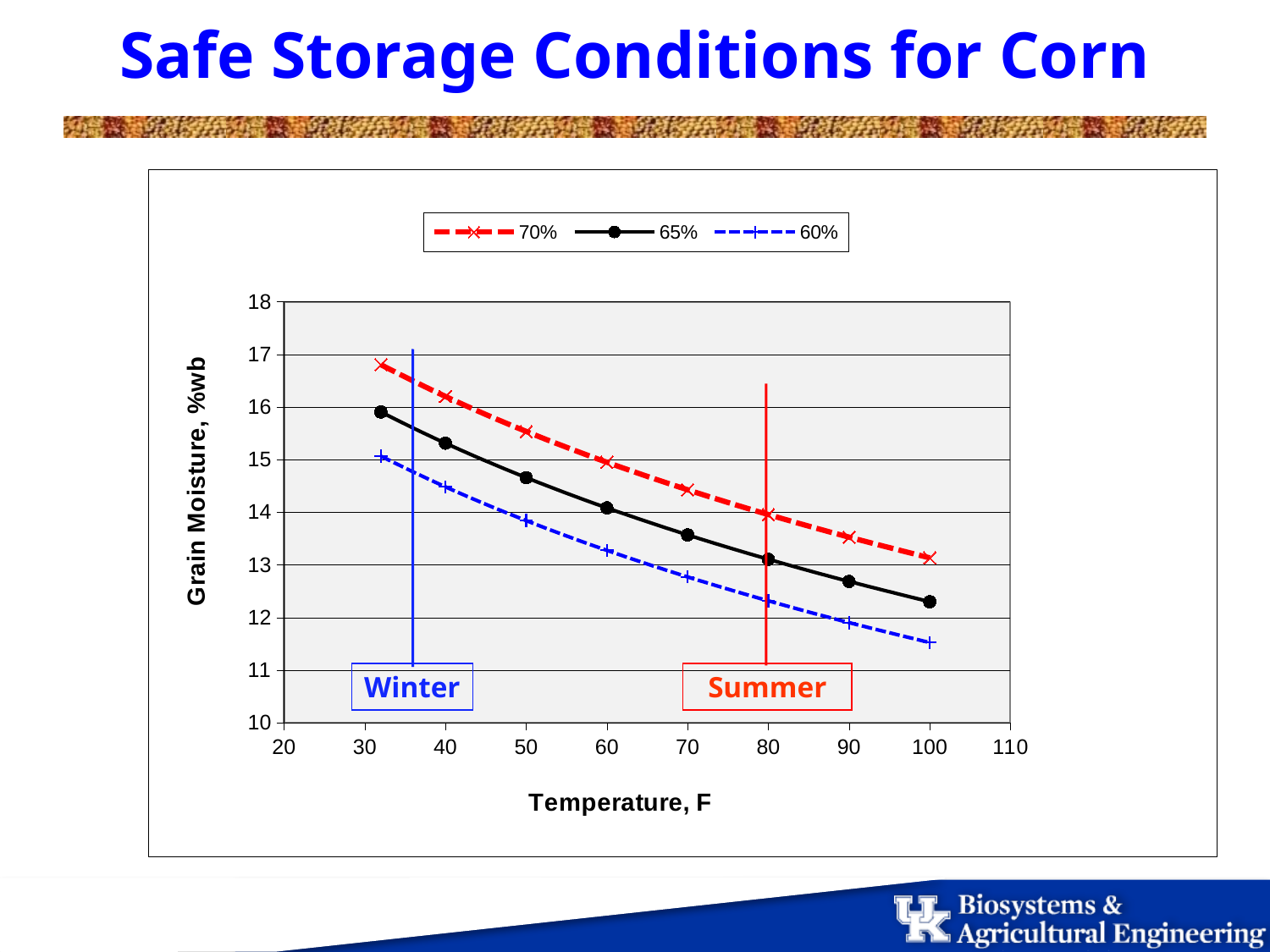
At 60 F, which series has the larger grain moisture value, 70% or 60%? 70% As temperature increases along the x axis, do the grain moisture values rise or fall? fall Is the value for the 70% series at 100 F greater or less than 13? greater Which series has the lowest grain moisture at every temperature? 60% What kind of chart is shown on the slide? line chart Is the value for the 60% series at 100 F greater or less than 12? less Is the value for the 60% series at 80 F greater or less than 12? greater How many series does the legend list? 3 What is the title of the x axis? Temperature, F What is the title of the y axis? Grain Moisture, %wb Which series has the highest grain moisture at every temperature? 70%